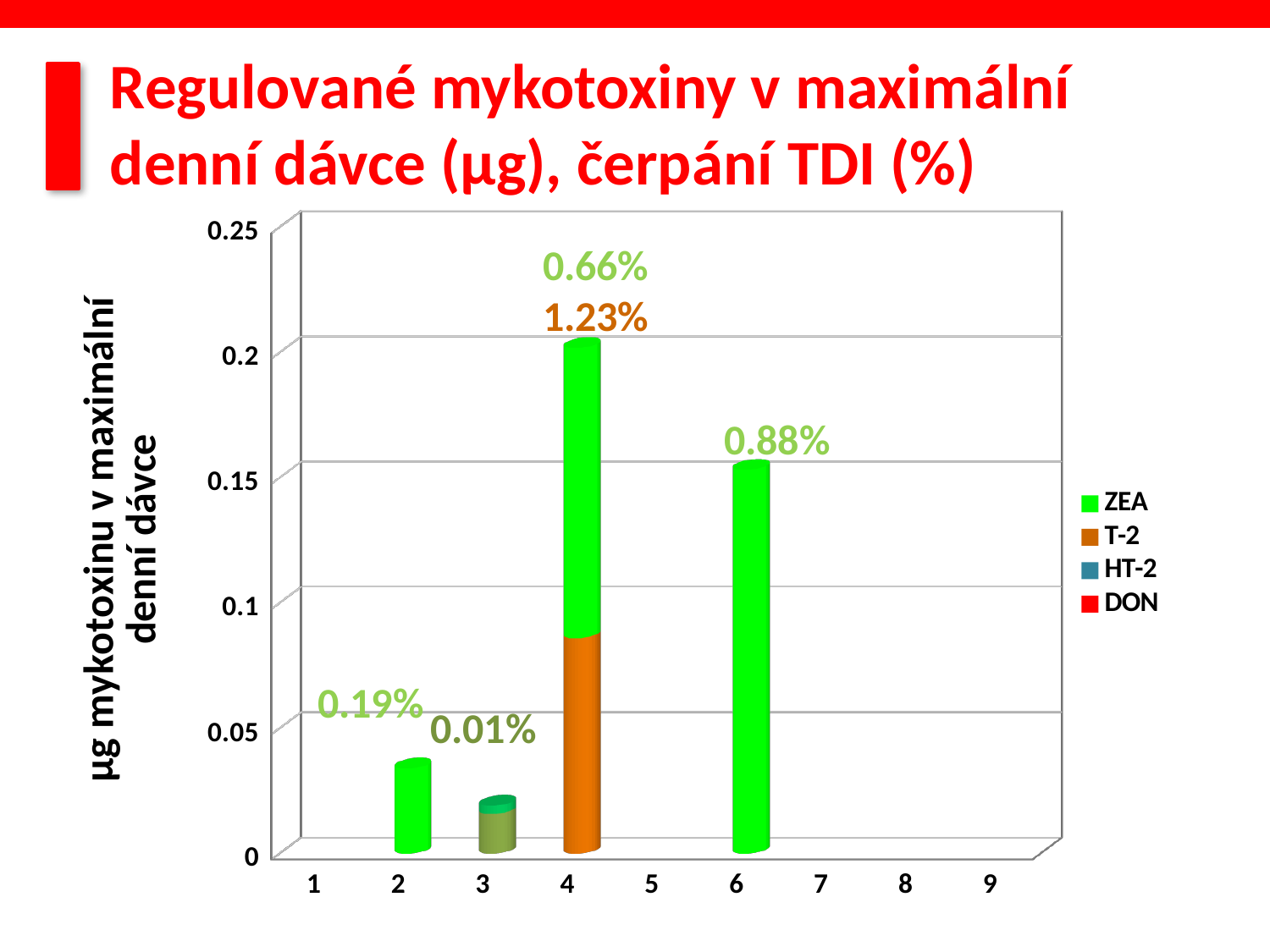
How many categories are shown on the x axis? 9 What percentage label is shown above the bar for category 2? 0.19% What percentage label is shown above the bar for category 6? 0.88% Which category has the tallest bar? 4 Which bar is taller, category 4 or category 6? category 4 What is the orange (T-2) percentage label shown above the bar for category 4? 1.23% What colour does the legend assign to DON? red What kind of chart is shown on the slide? bar chart Is the value for category 2 greater or less than 0.05? less What percentage label is shown above the bar for category 3? 0.01% How many series does the legend list? 4 Is the total height of the bar for category 4 greater or less than 0.15? greater